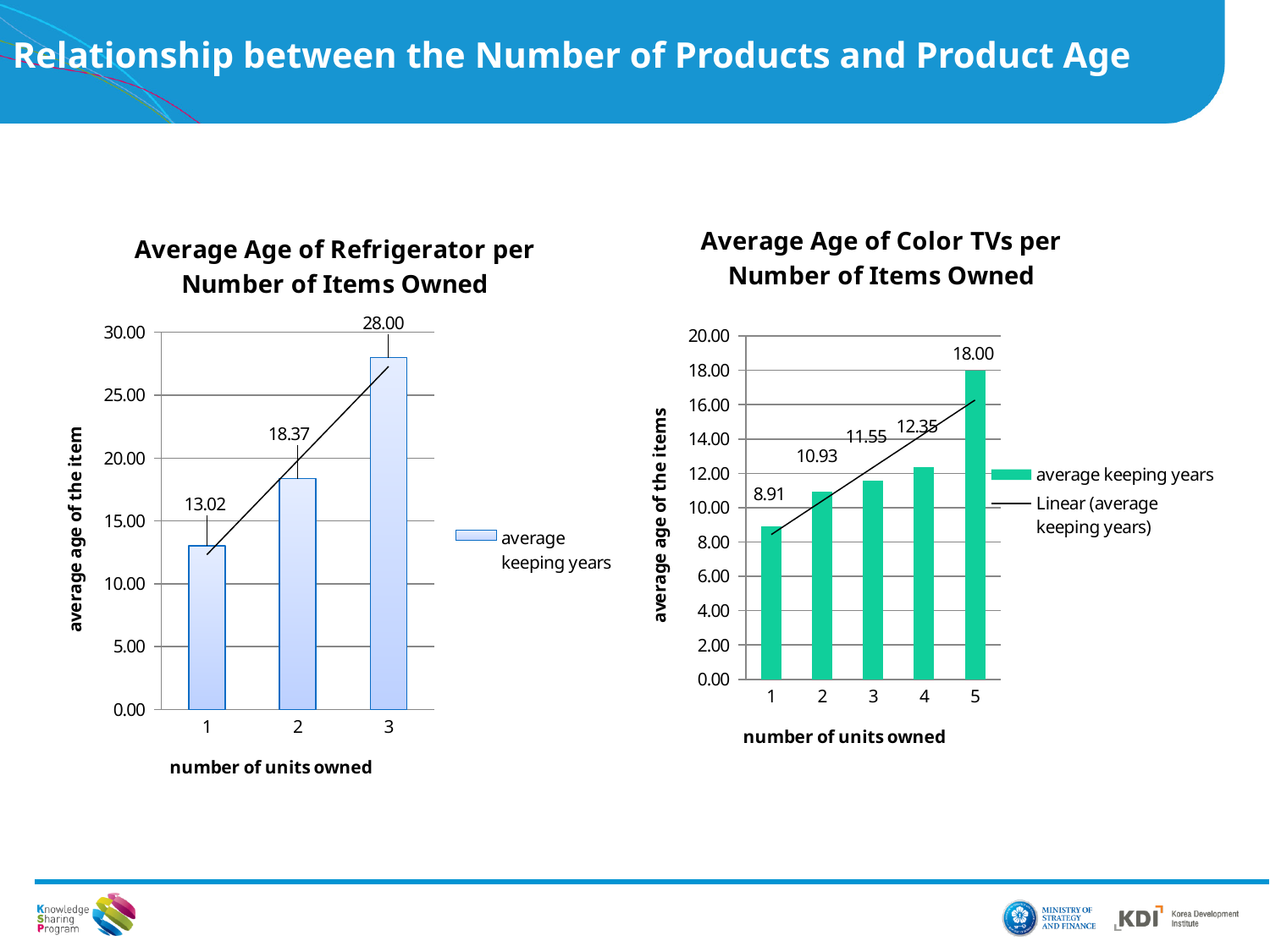
In the 'Average Age of Color TVs per Number of Items Owned' chart, how many entries does the legend list? 2 In the 'Average Age of Refrigerator per Number of Items Owned' chart, what is the average keeping years for 2 units owned? 18.37 In the 'Average Age of Color TVs per Number of Items Owned' chart, which number of units owned has the lowest average keeping years? 1 In the 'Average Age of Refrigerator per Number of Items Owned' chart, how many categories are shown on the x axis? 3 In the 'Average Age of Color TVs per Number of Items Owned' chart, what is the average keeping years for 3 units owned? 11.55 In the 'Average Age of Refrigerator per Number of Items Owned' chart, what is the difference in average keeping years between 3 units and 1 unit owned? 14.98 In the 'Average Age of Color TVs per Number of Items Owned' chart, what is the difference in average keeping years between 5 units and 4 units owned? 5.65 In the 'Average Age of Refrigerator per Number of Items Owned' chart, is the value for 1 unit owned greater or less than 15.00? less In the 'Average Age of Refrigerator per Number of Items Owned' chart, which number of units owned has the highest average keeping years? 3 What kind of chart is the 'Average Age of Color TVs per Number of Items Owned' chart? bar chart In the 'Average Age of Color TVs per Number of Items Owned' chart, do the average keeping years rise or fall as the number of units owned increases? rise In the 'Average Age of Color TVs per Number of Items Owned' chart, what colour are the bars? green